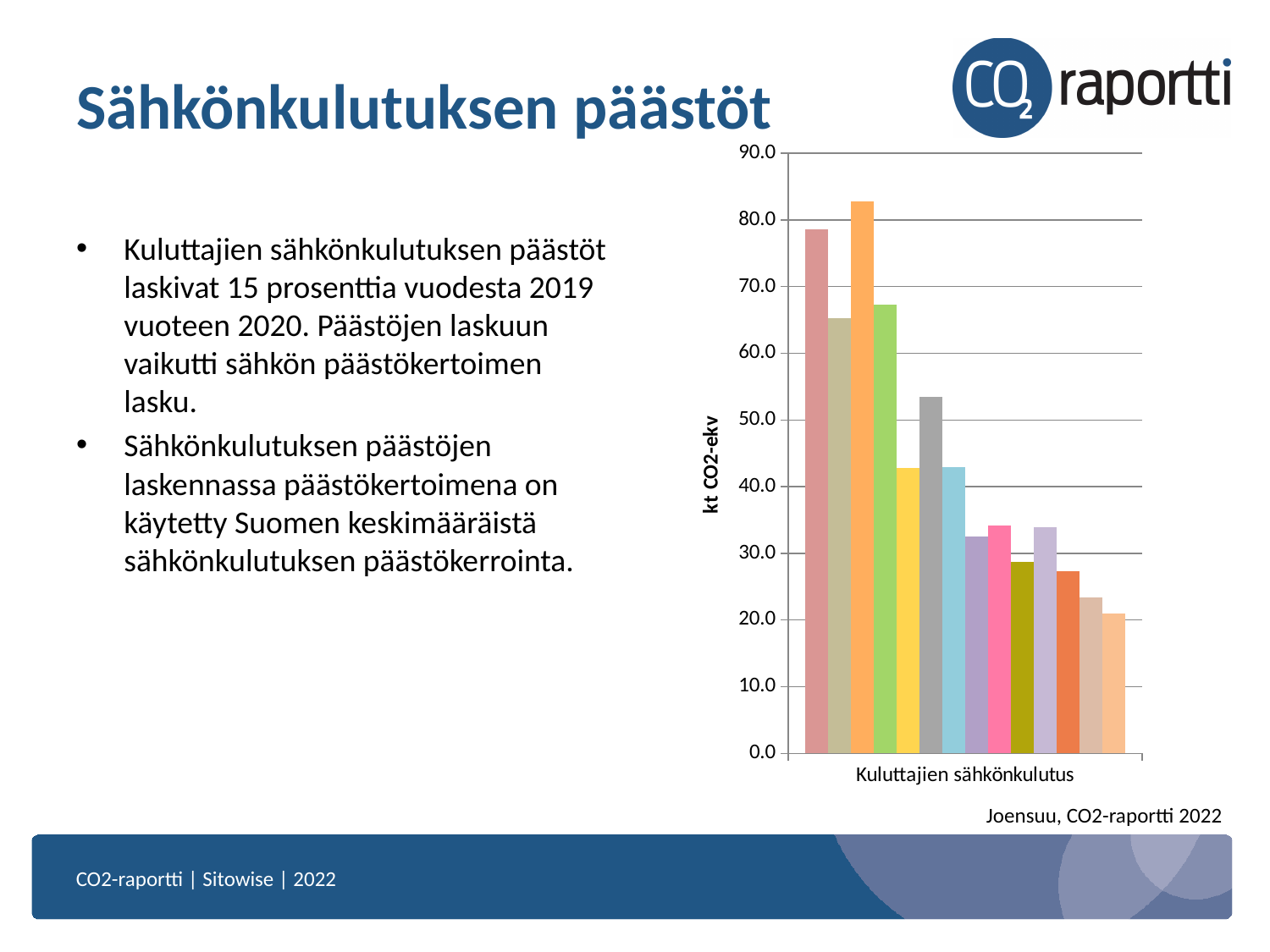
What is the category label shown under the bars on the x axis? Kuluttajien sähkönkulutus Which is larger, the leftmost bar or the rightmost bar in the chart? the leftmost bar Do the bar values generally rise or fall from left to right across the chart? fall How many bars are plotted in the chart? 14 Is the value of the shortest bar in the chart greater or less than 30.0? less Is the value of the grey bar in the chart greater or less than 50.0? greater What is the label on the vertical axis of the chart? kt CO2-ekv What kind of chart is shown on the slide? bar chart Is the value of the tallest bar in the chart greater or less than 80.0? greater